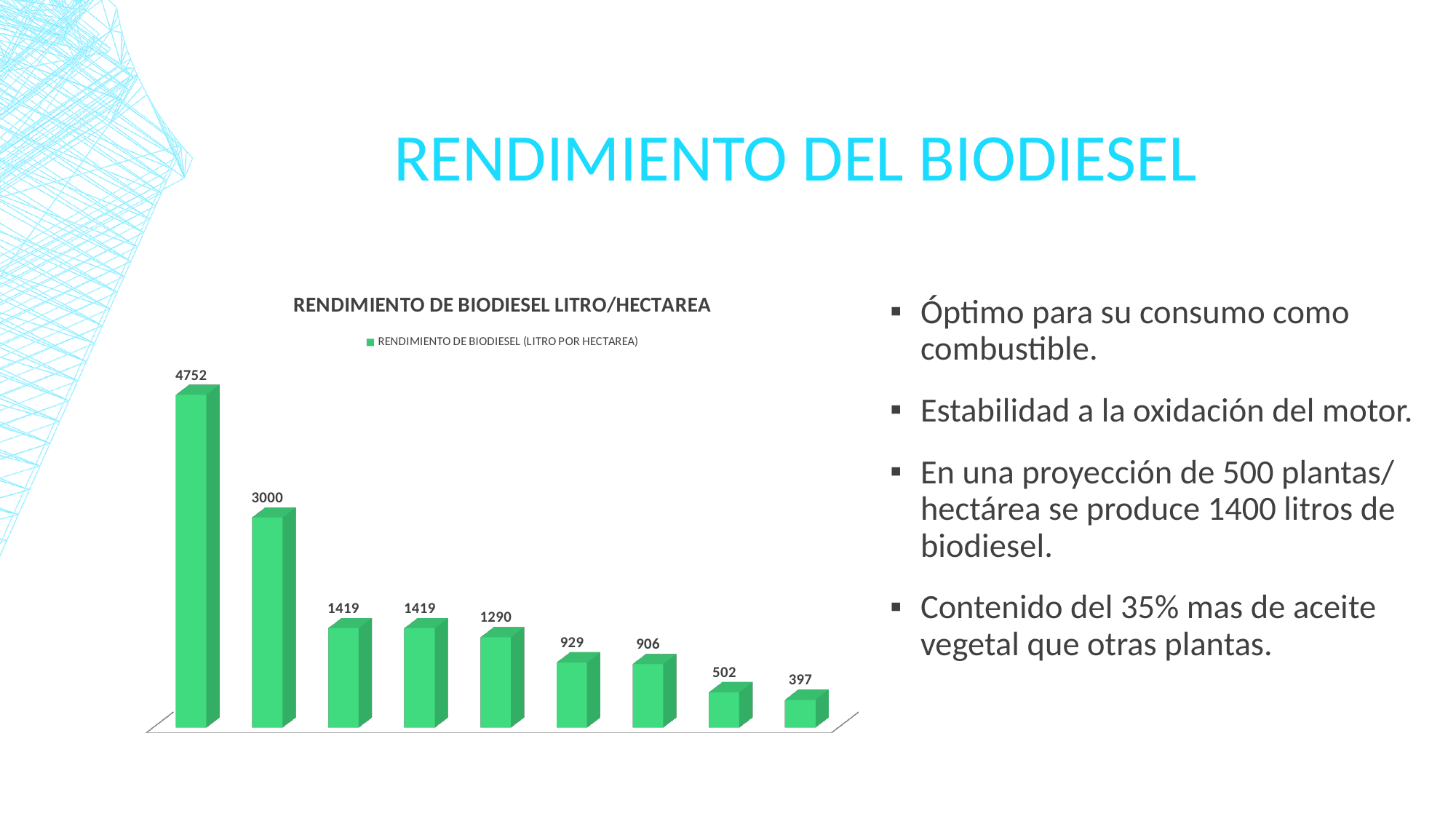
How many bars are plotted in the chart? 9 What is the value of the rightmost bar in the chart? 397 What is the highest value shown in the chart? 4752 Do the bar values rise or fall from left to right across the chart? Fall How many series does the chart legend list? 1 What is the title of the chart? RENDIMIENTO DE BIODIESEL LITRO/HECTAREA What is the lowest value shown in the chart? 397 What is the value of the leftmost bar in the chart? 4752 What is the difference between the highest and lowest values in the chart? 4355 What kind of chart is shown on the slide? Bar chart What is the value of the second bar from the left in the chart? 3000 What series name is shown in the chart legend? RENDIMIENTO DE BIODIESEL (LITRO POR HECTAREA)